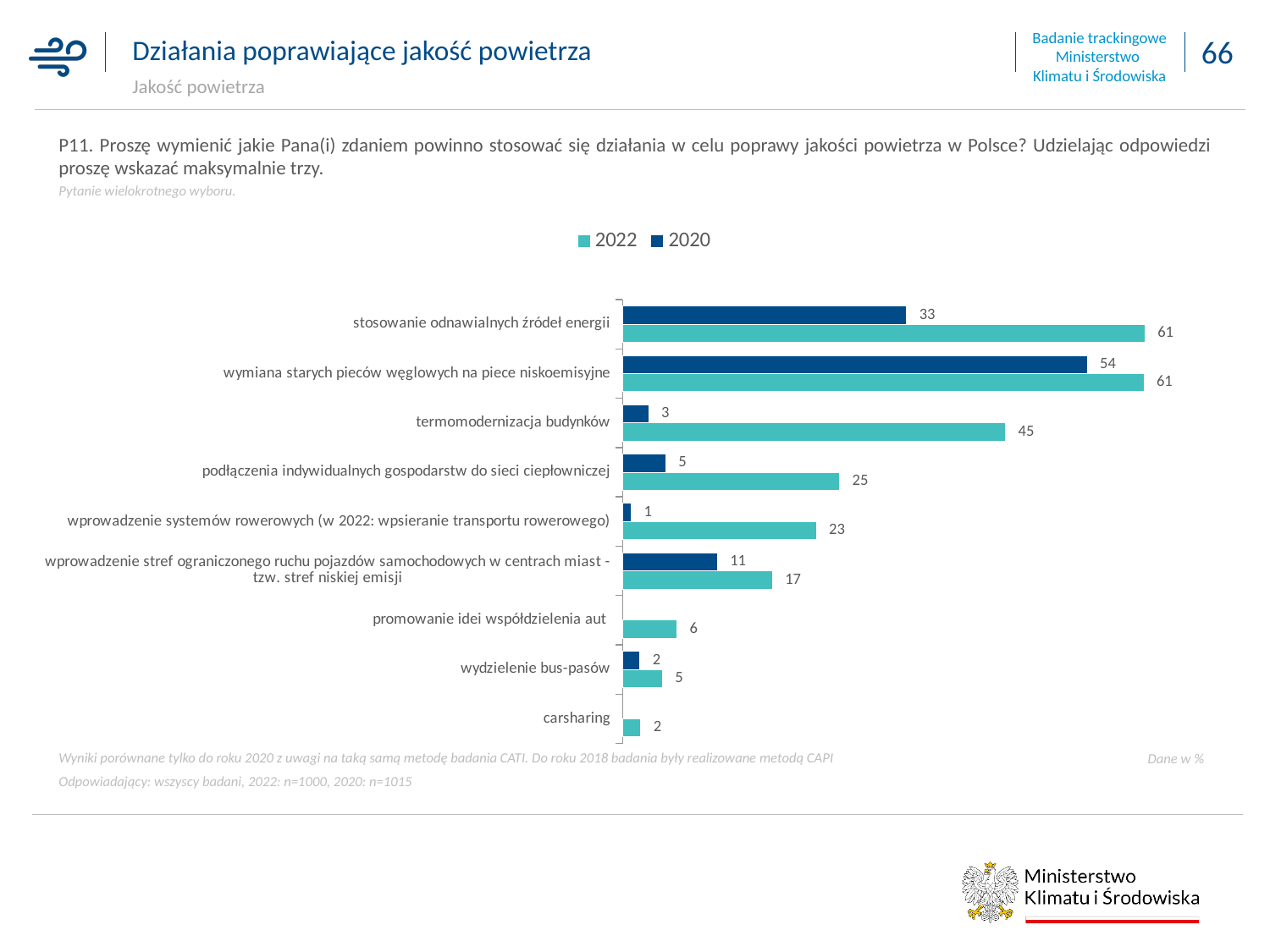
What is the difference between the 2022 and 2020 values for termomodernizacja budynków? 42 Which category has the lowest 2022 value? carsharing How many categories are shown on the chart? 9 What kind of chart is shown on the slide? bar chart Which category has the highest 2020 value? wymiana starych pieców węglowych na piece niskoemisyjne Which is larger for podłączenia indywidualnych gospodarstw do sieci ciepłowniczej: the 2022 value or the 2020 value? 2022 What are the two series named in the legend? 2022 and 2020 What is the 2022 value for wprowadzenie stref ograniczonego ruchu pojazdów samochodowych w centrach miast - tzw. stref niskiej emisji? 17 What is the difference between the 2022 and 2020 values for stosowanie odnawialnych źródeł energii? 28 What is the 2022 value for termomodernizacja budynków? 45 What is the 2020 value for stosowanie odnawialnych źródeł energii? 33 How many series does the legend list? 2